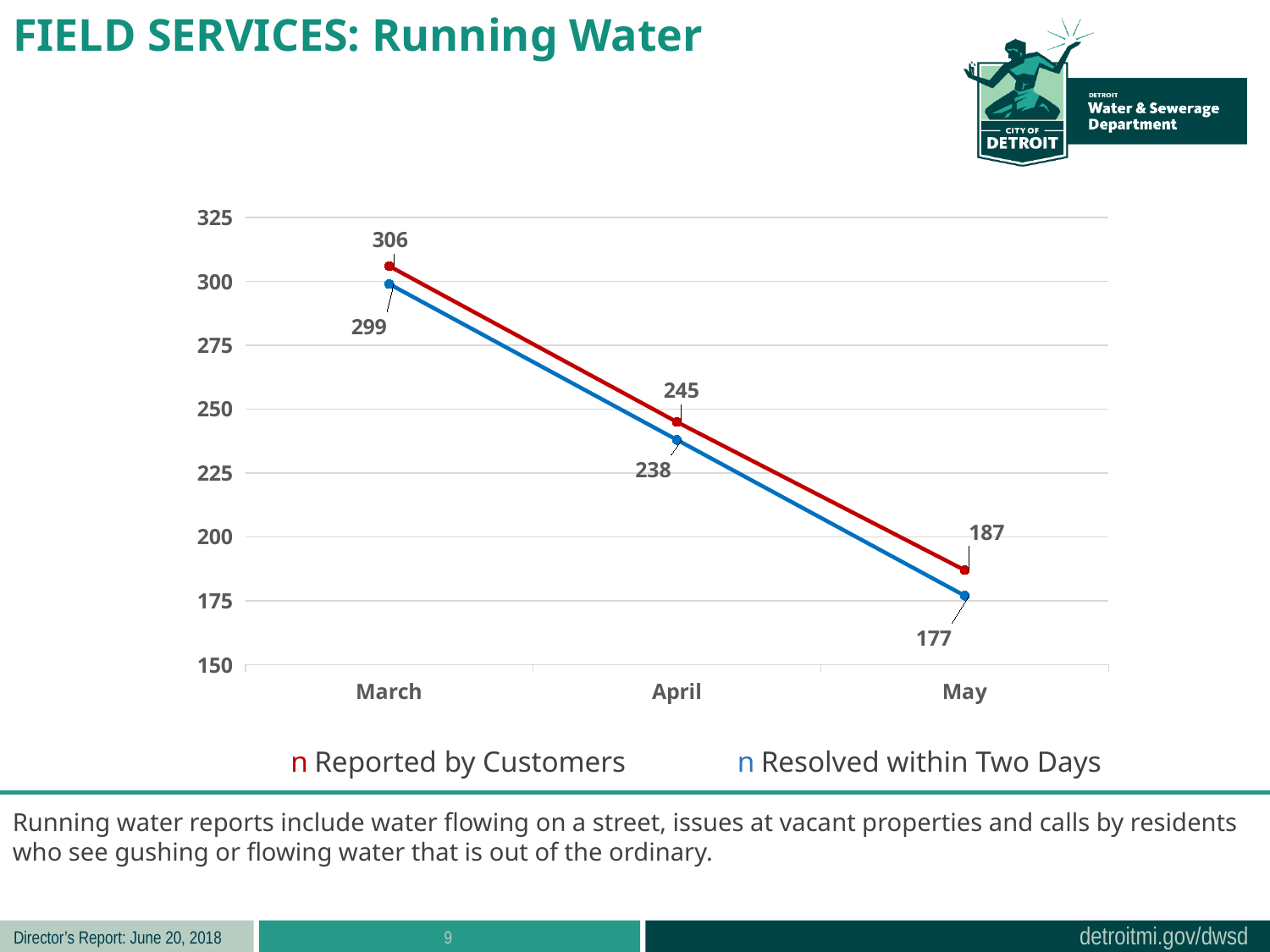
Which is larger in May: Reported by Customers or Resolved within Two Days? Reported by Customers What was the value for Resolved within Two Days in April? 238 How many running water reports were Resolved within Two Days in May? 177 How many months are shown on the x axis? 3 By how much did the number Reported by Customers fall from March to May? 119 Do the values for Reported by Customers rise or fall from March to May? Fall What is the difference between reports Reported by Customers and those Resolved within Two Days in April? 7 In which month was the number Resolved within Two Days lowest? May What was the number of running water reports Reported by Customers in March? 306 How many series does the legend list? 2 What kind of chart is shown on the slide? Line chart In which month was the number Reported by Customers highest? March